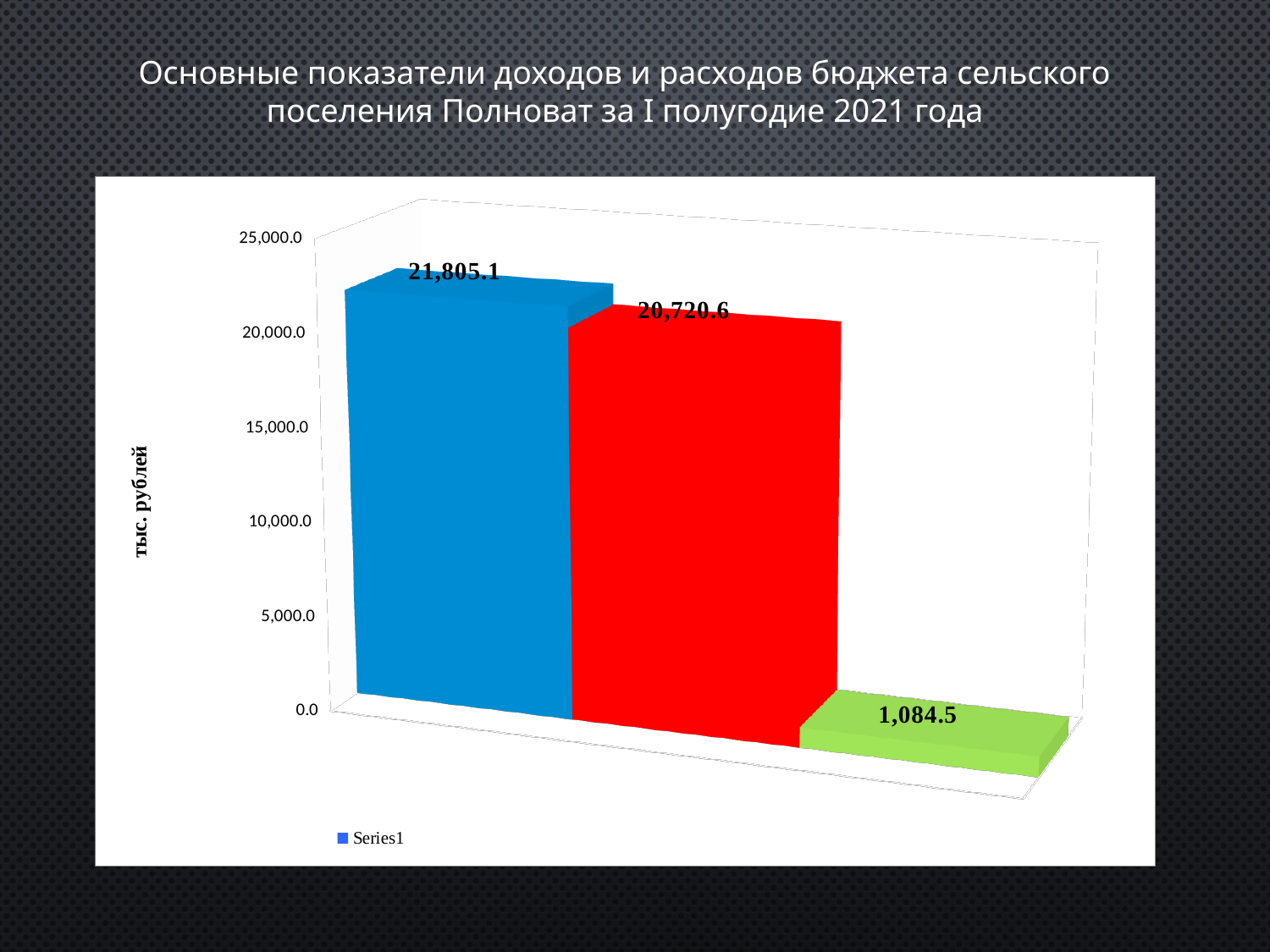
What is the label on the vertical axis of the chart? тыс. рублей Is the value of the green bar greater or less than 5,000.0? less Which bar has the highest value? the blue bar How many bars are plotted in the chart? 3 Which is larger, the value of the blue bar or the value of the red bar? the blue bar What is the difference between the blue bar's value and the red bar's value? 1,084.5 Which bar has the lowest value? the green bar What value is shown on the green bar? 1,084.5 What value is shown on the blue bar? 21,805.1 What value is shown on the red bar? 20,720.6 What kind of chart is shown on the slide? bar chart What is the difference between the red bar's value and the green bar's value? 19,636.1